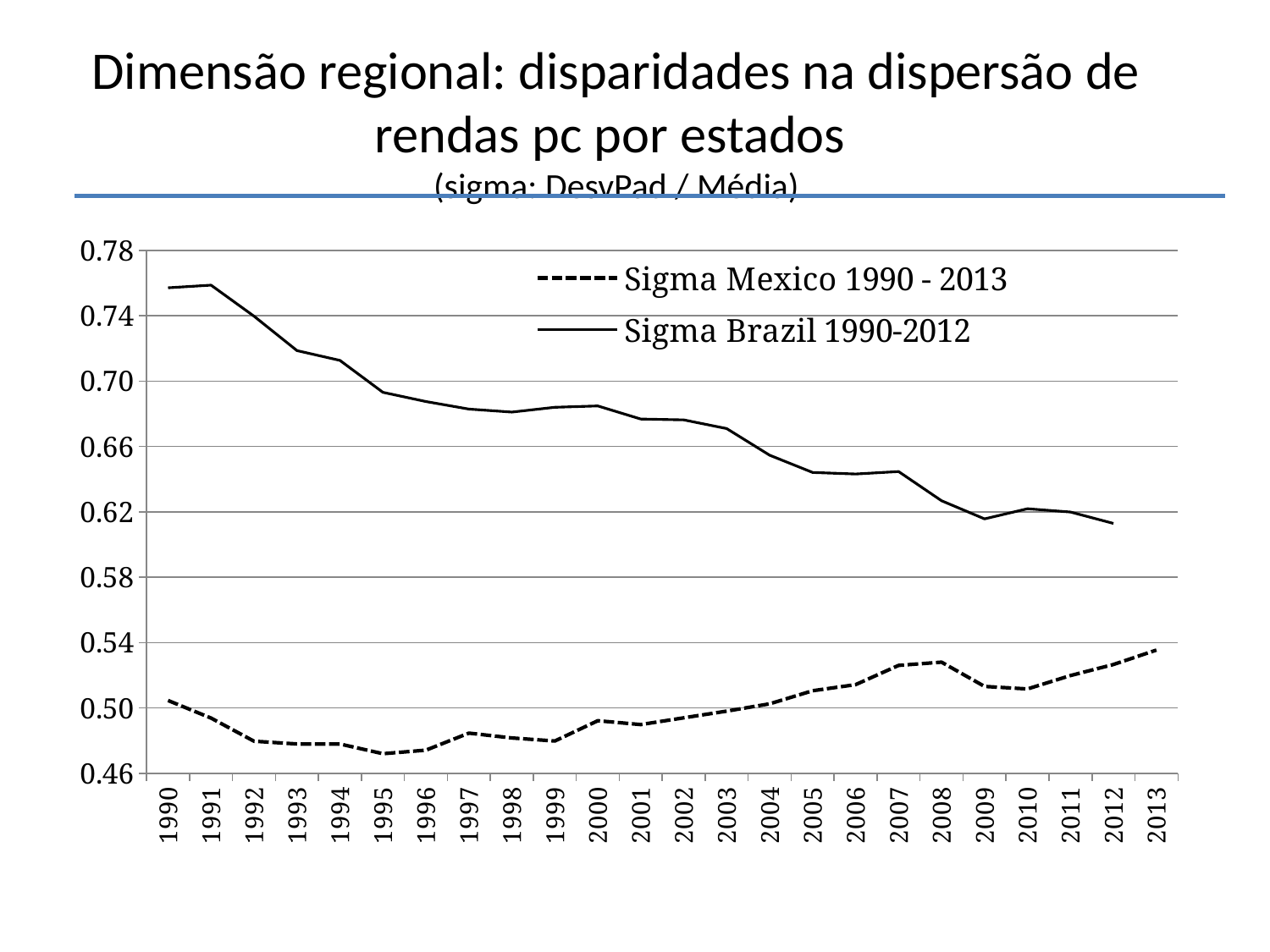
How many series does the legend list? 2 In which year does the Sigma Mexico 1990 - 2013 series reach its lowest value? 1995 Which series is drawn with a dashed line? Sigma Mexico 1990 - 2013 In 2000, which series has the larger value, Sigma Mexico 1990 - 2013 or Sigma Brazil 1990-2012? Sigma Brazil 1990-2012 Is the value for Sigma Brazil 1990-2012 in 2012 greater or less than 0.62? less Is the value for Sigma Brazil 1990-2012 in 1990 greater or less than 0.74? greater Does the Sigma Brazil 1990-2012 series rise or fall overall from 1990 to 2012? fall How many years are shown on the x axis? 24 What kind of chart is shown on the slide? line chart Does the Sigma Mexico 1990 - 2013 series rise or fall overall from 1995 to 2013? rise